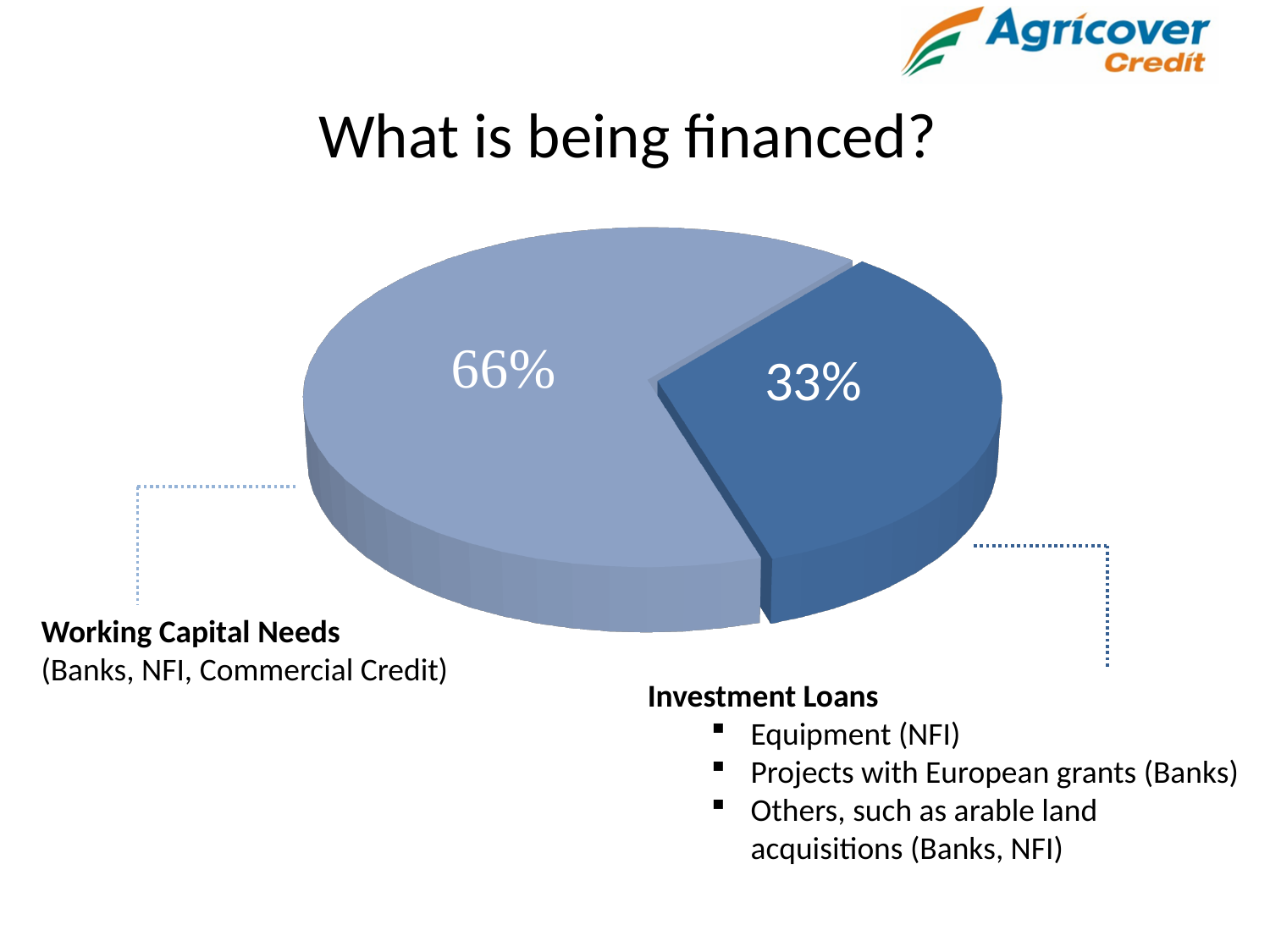
What share of the pie is labelled Investment Loans? 33% Which slice of the pie is the largest? Working Capital Needs What is the title of the slide containing the pie chart? What is being financed? What kind of chart is shown on the slide? pie chart How many slices does the pie chart have? 2 Is the Working Capital Needs share greater or less than 50%? greater What is the difference in percentage points between the Working Capital Needs slice and the Investment Loans slice? 33 Which is larger, the Working Capital Needs slice or the Investment Loans slice? Working Capital Needs Which slice is shown in the darker blue colour? Investment Loans Which slice of the pie is the smallest? Investment Loans What share of the pie is labelled Working Capital Needs? 66%